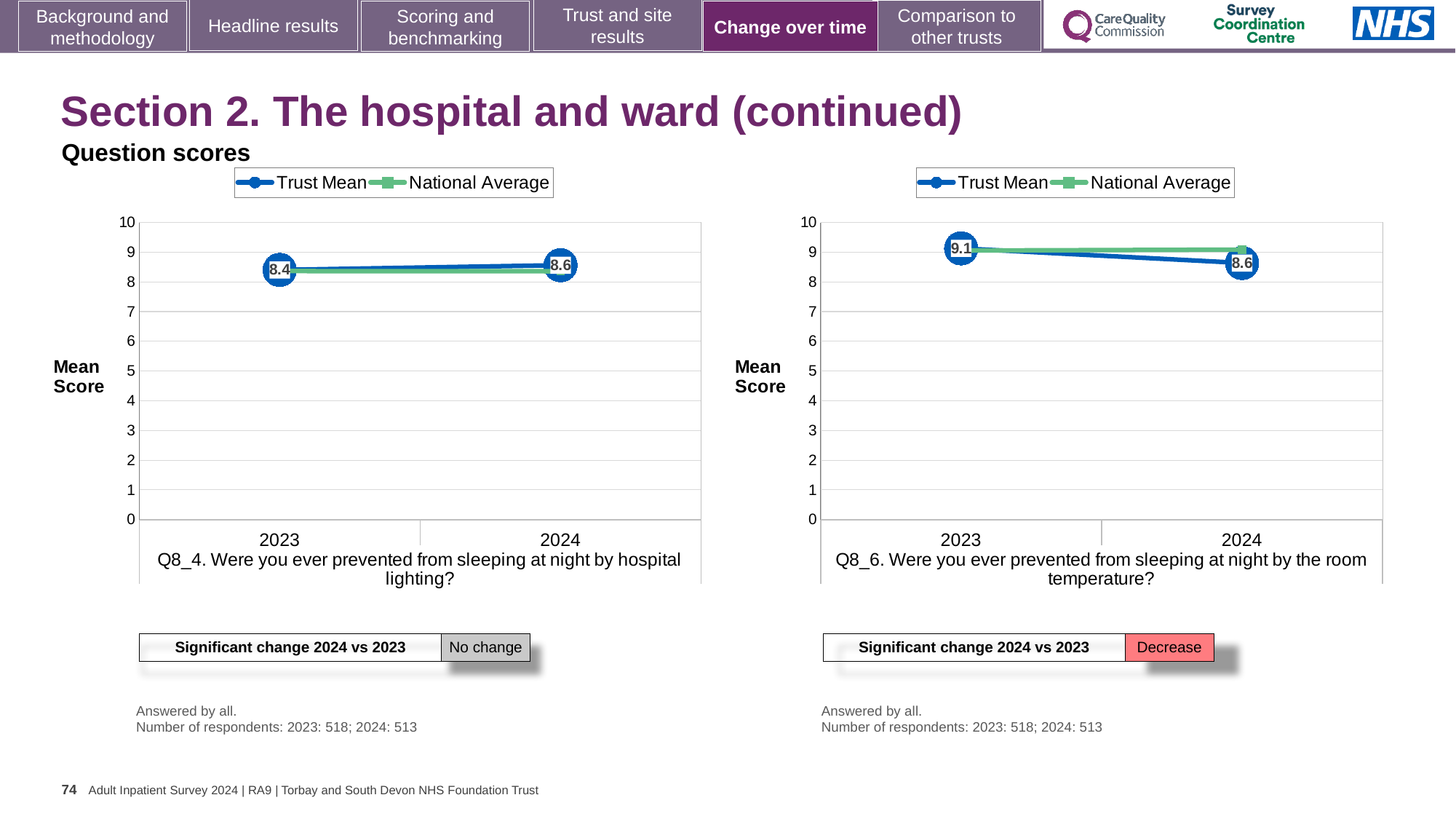
How many series does the legend of the Q8_6 room temperature chart list? 2 What kind of chart is the Q8_4 hospital lighting chart? line chart In the Q8_4 hospital lighting chart, does the Trust Mean rise or fall from 2023 to 2024? rise In the Q8_4 hospital lighting chart, what is the Trust Mean score for 2023? 8.4 In the Q8_6 room temperature chart, does the Trust Mean rise or fall from 2023 to 2024? fall In the Q8_4 hospital lighting chart, is the National Average for 2023 greater or less than 8? greater In the Q8_6 room temperature chart, what is the Trust Mean score for 2024? 8.6 In the Q8_6 room temperature chart, what is the Trust Mean score for 2023? 9.1 In the Q8_4 hospital lighting chart, what is the Trust Mean score for 2024? 8.6 In the Q8_6 room temperature chart, which year has the higher Trust Mean, 2023 or 2024? 2023 In the Q8_6 room temperature chart, by how much did the Trust Mean change from 2023 to 2024? 0.5 In the Q8_4 hospital lighting chart, what is the difference between the Trust Mean for 2024 and 2023? 0.2